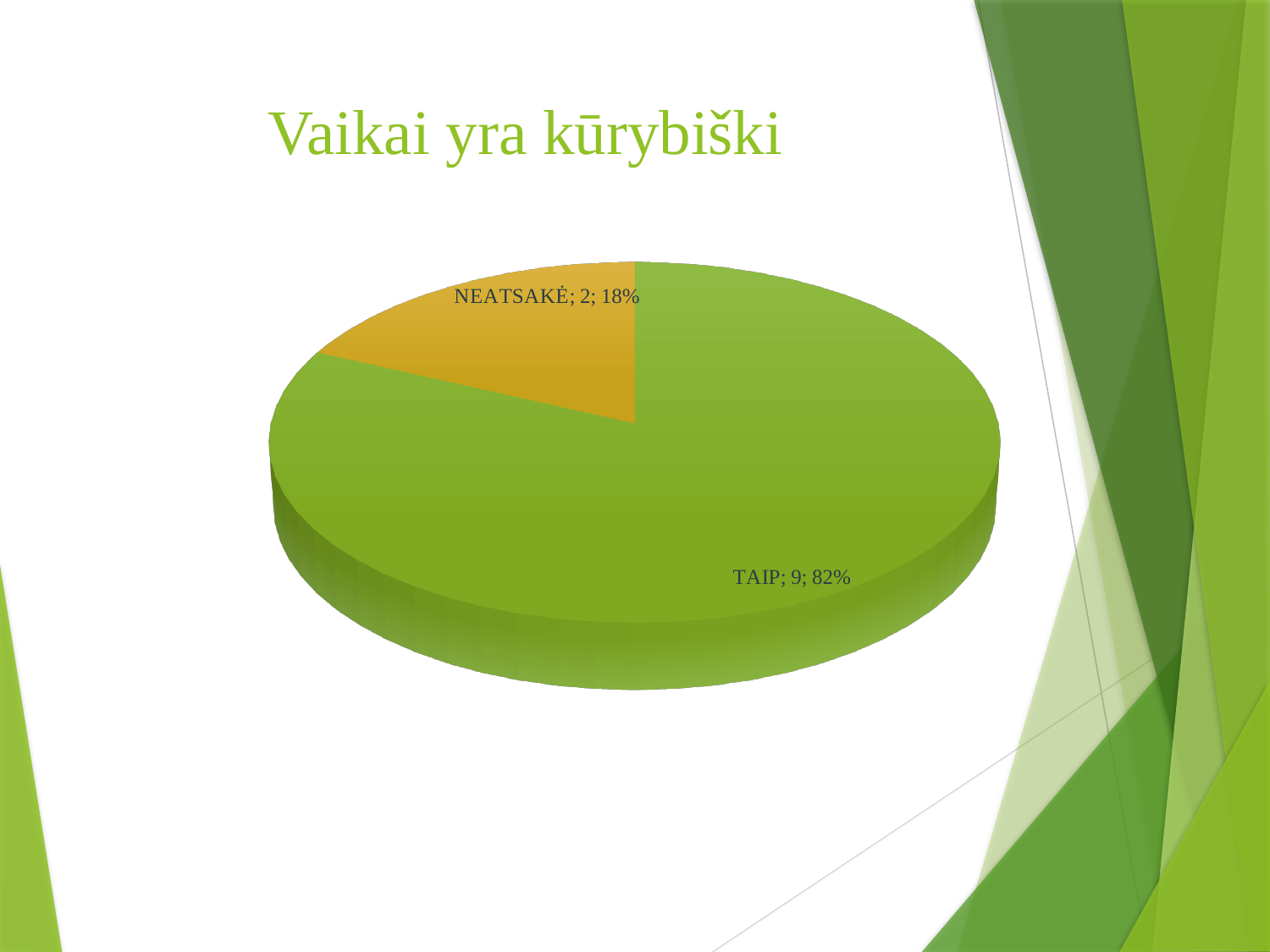
What is the title of the slide containing the chart? Vaikai yra kūrybiški How many slices does the pie chart have? 2 What is the value for NEATSAKĖ? 2 Which slice is the largest? TAIP What share of the pie does TAIP represent? 82% Which slice is the smallest? NEATSAKĖ What share of the pie does NEATSAKĖ represent? 18% What kind of chart is shown on the slide? pie chart What is the difference between the values for TAIP and NEATSAKĖ? 7 What is the value for TAIP? 9 Which is larger, TAIP or NEATSAKĖ? TAIP What is the total of all slices in the pie chart? 11